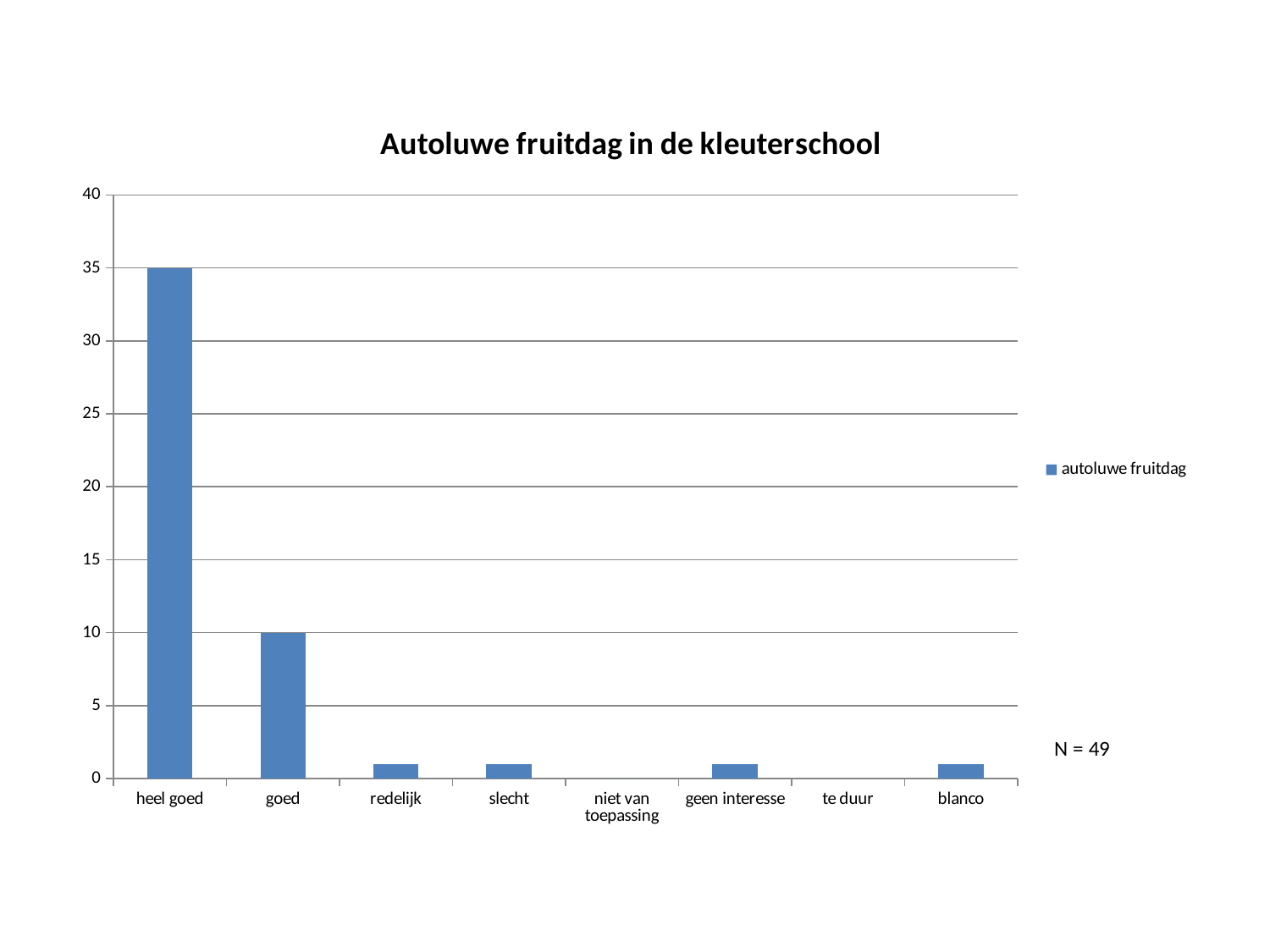
What is the difference between the values for 'heel goed' and 'goed'? 25 What series name is shown in the legend? autoluwe fruitdag Is the value for 'heel goed' greater or less than 30? greater What is the value for 'heel goed'? 35 What is the title of the chart? Autoluwe fruitdag in de kleuterschool Which has a larger value, 'goed' or 'redelijk'? goed How many categories are shown on the x axis? 8 What is the value for 'goed'? 10 Is the value for 'redelijk' greater or less than 5? less What kind of chart is shown on the slide? bar chart How many series does the legend list? 1 Which category has the highest value in the chart? heel goed